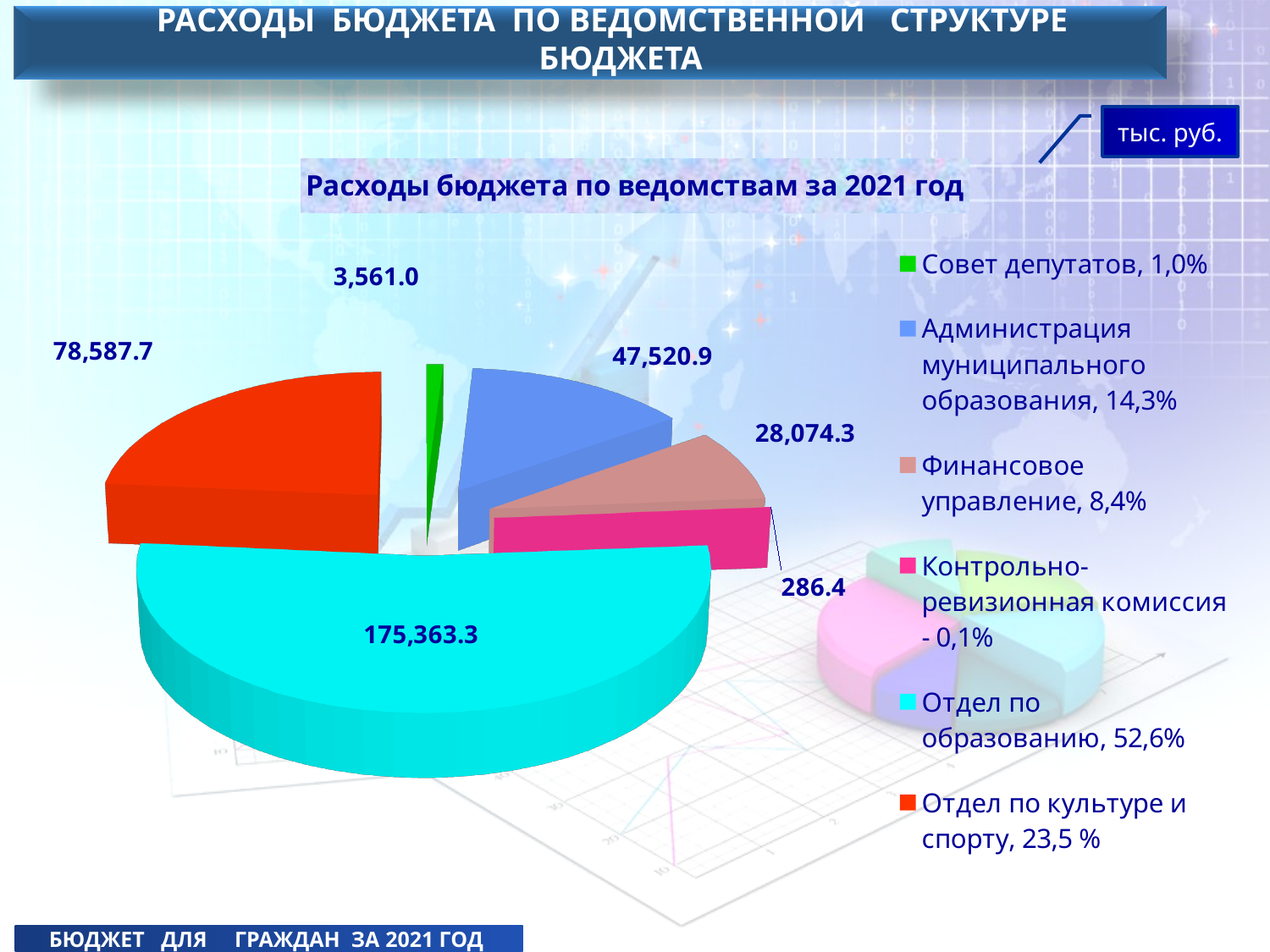
Which category has the largest value? Отдел по образованию What share of the pie does Отдел по культуре и спорту represent? 23,5 % Which is larger, the value for Отдел по культуре и спорту or the value for Финансовое управление? Отдел по культуре и спорту Which category has the smallest value? Контрольно-ревизионная комиссия What is the value for Совет депутатов? 3,561.0 What is the value for Контрольно-ревизионная комиссия? 286.4 What share of the pie does Финансовое управление represent? 8,4% What type of chart is shown on the slide? pie chart What is the value for Отдел по образованию? 175,363.3 What is the title of the chart? Расходы бюджета по ведомствам за 2021 год What is the value for Администрация муниципального образования? 47,520.9 How many categories does the legend list? 6